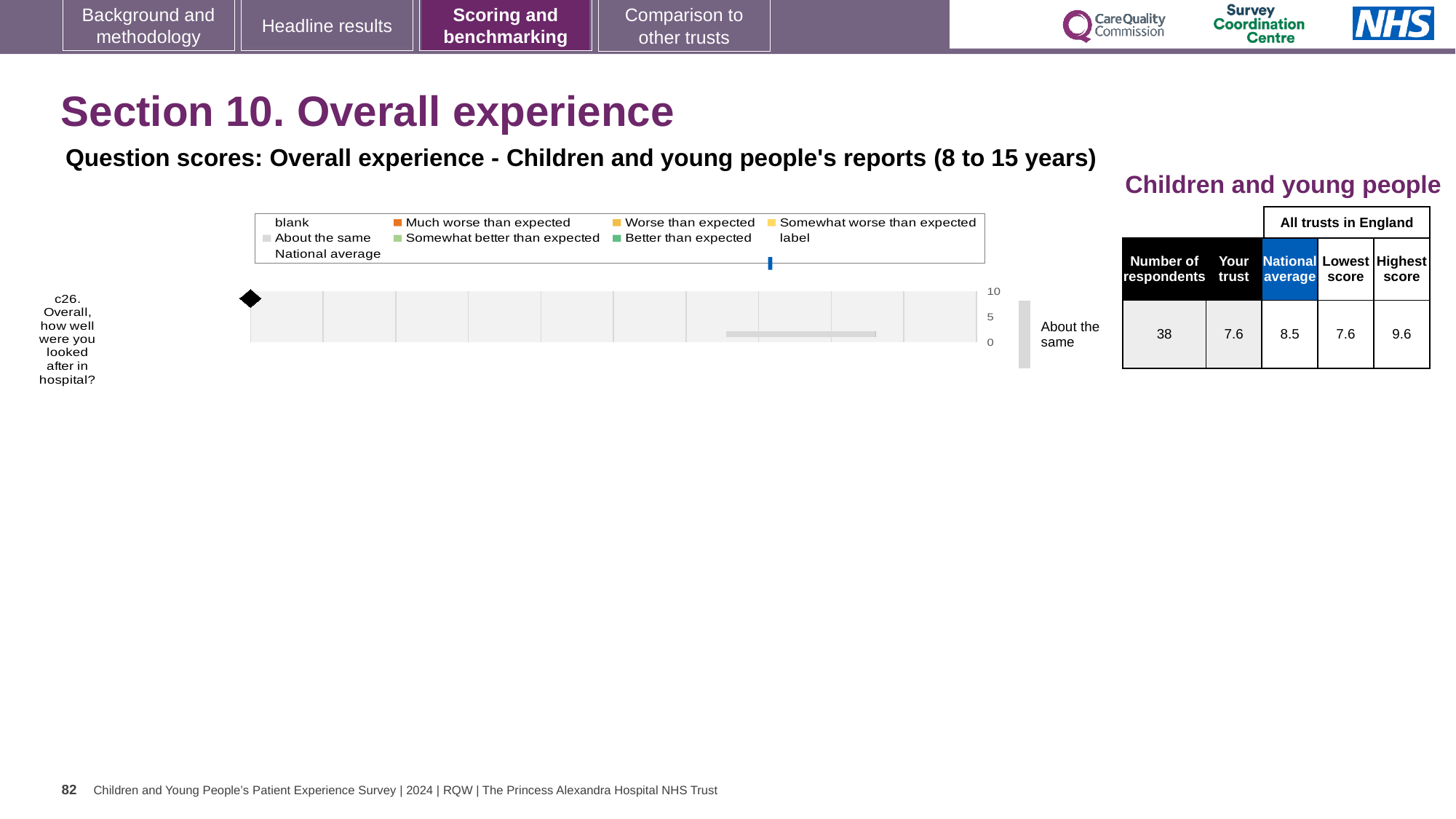
What is the difference between the national average and the 'Your trust' score for question c26? 0.9 What is the 'Your trust' score for question c26 (Overall, how well were you looked after in hospital?)? 7.6 What is the highest score among all trusts in England for question c26? 9.6 Which is larger for question c26: the 'Your trust' score or the national average? National average Is the 'Your trust' score for question c26 greater or less than 5? greater How many questions are plotted in the chart? 1 How many respondents answered question c26? 38 What is the lowest score among all trusts in England for question c26? 7.6 What is the national average score for question c26? 8.5 What benchmark category is shown for question c26? About the same What is the difference between the highest score and the lowest score for question c26? 2.0 What type of chart is used to show the question scores for c26? bar chart